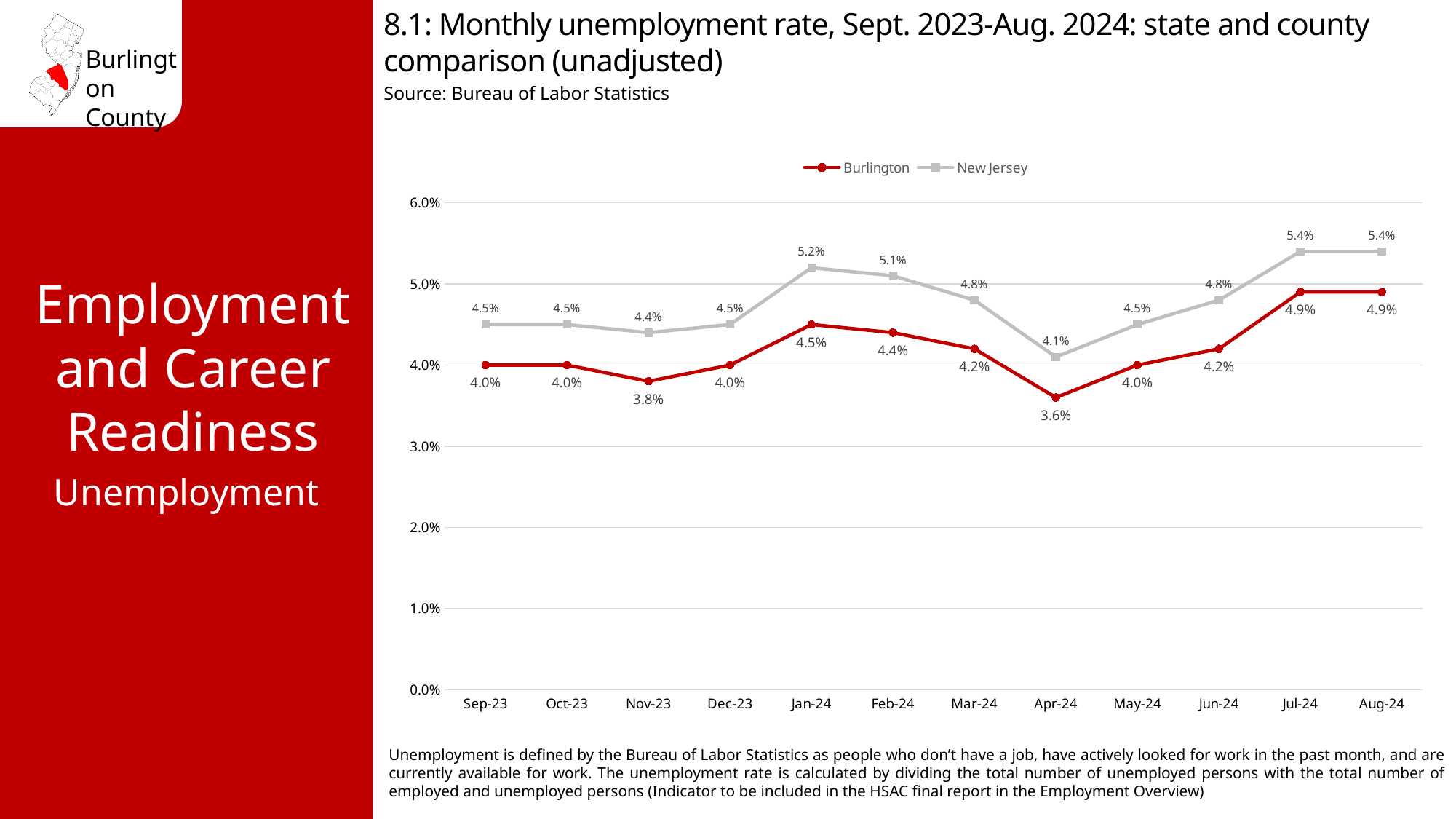
What was Burlington's unemployment rate in Nov-23? 3.8% In which month was Burlington's unemployment rate lowest? Apr-24 What is the highest unemployment rate shown for New Jersey? 5.4% What was Burlington's unemployment rate in Apr-24? 3.6% Did Burlington's unemployment rate rise or fall from Apr-24 to Jul-24? Rise How many months are plotted on the x axis? 12 What was New Jersey's unemployment rate in Jan-24? 5.2% What is the difference between New Jersey's and Burlington's unemployment rates in Jan-24? 0.7 percentage points How many series does the legend list? 2 In Aug-24, which had the higher unemployment rate, Burlington or New Jersey? New Jersey What kind of chart is shown on the slide? Line chart In which month was New Jersey's unemployment rate lowest? Apr-24